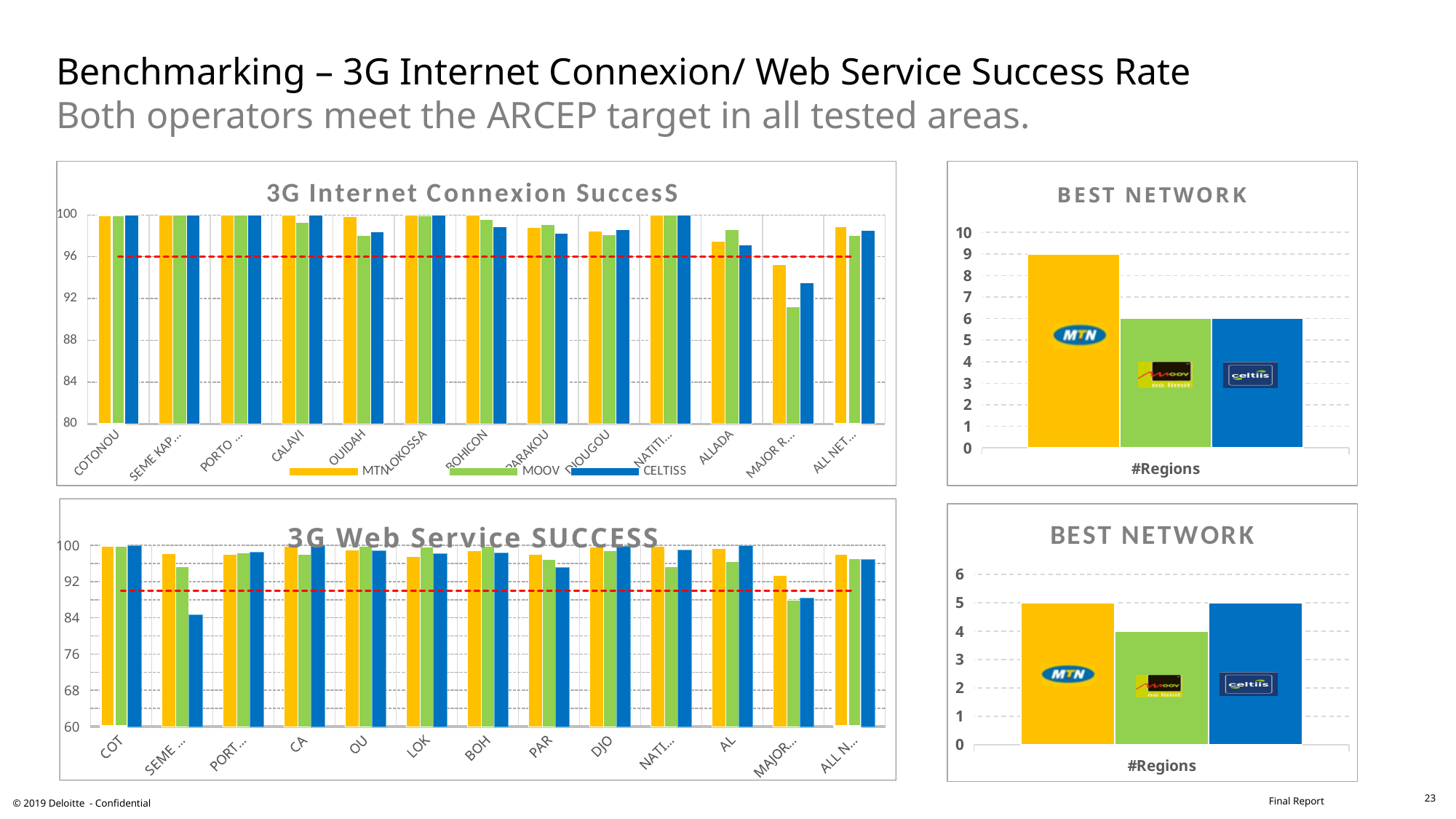
In the bottom-right BEST NETWORK chart, which has more regions, MTN or MOOV? MTN In the 3G Web Service SUCCESS chart, is the CELTISS value for SEME ... greater or less than 92? less In the 3G Internet Connexion SuccesS chart, is the MOOV value for MAJOR R... greater or less than 96? less In the top-right BEST NETWORK chart, how many regions does MOOV have? 6 In the top-right BEST NETWORK chart, what is the difference between the number of regions for MTN and for MOOV? 3 In the bottom-right BEST NETWORK chart, which operator has the lowest number of regions? MOOV How many categories are shown on the x axis of the 3G Web Service SUCCESS chart? 13 In the top-right BEST NETWORK chart, which operator has the highest number of regions? MTN In the bottom-right BEST NETWORK chart, how many regions does MTN have? 5 How many series does the legend of the 3G Internet Connexion SuccesS chart list? 3 In the top-right BEST NETWORK chart, how many regions does MTN have? 9 In the bottom-right BEST NETWORK chart, how many regions does MOOV have? 4